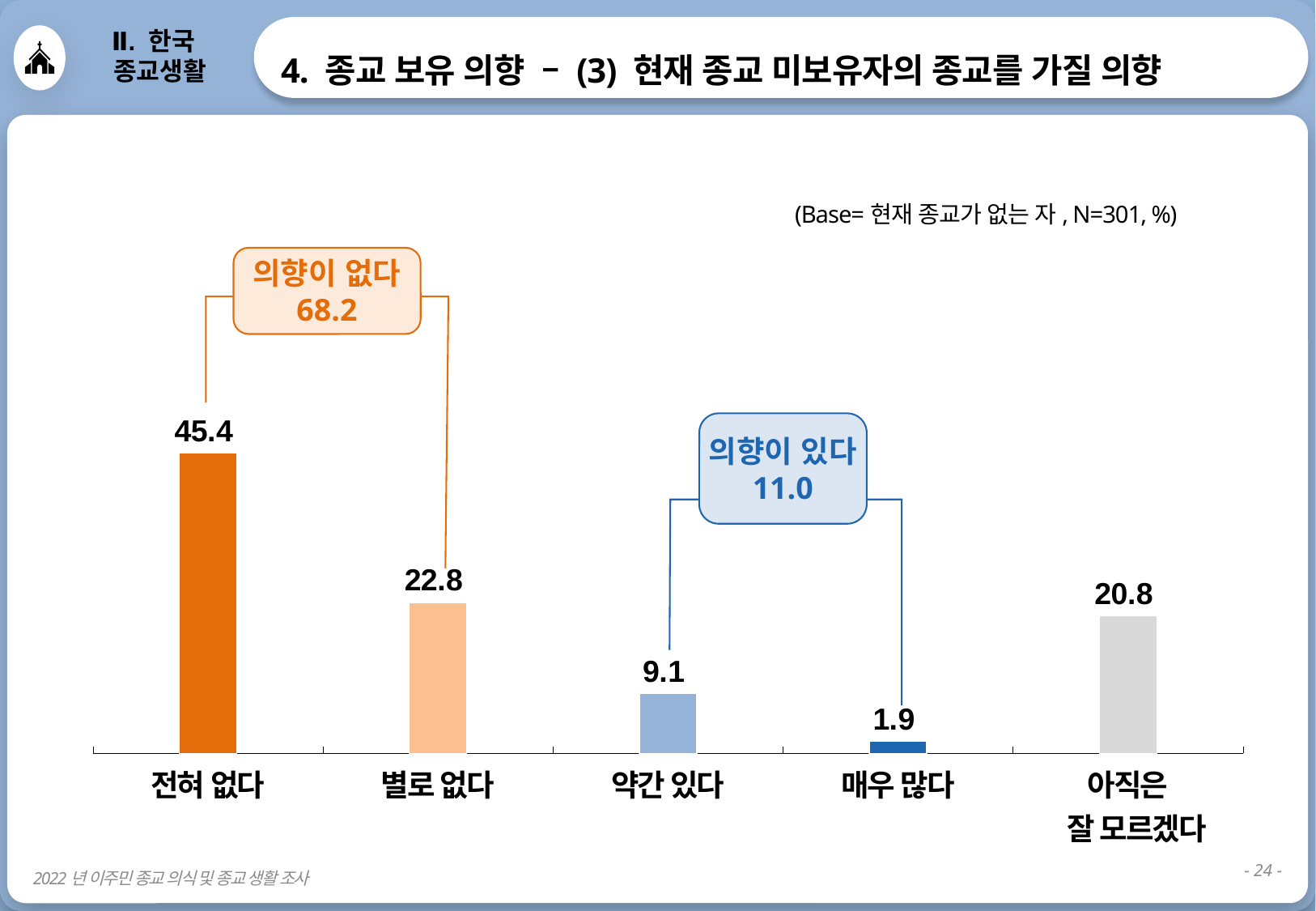
What is the difference between the values for 전혀 없다 and 별로 없다? 22.6 What kind of chart is shown on the slide? bar chart What combined value is shown in the callout labelled 의향이 없다? 68.2 What is the value for 매우 많다? 1.9 Which category has the lowest value? 매우 많다 How many categories are shown on the x axis? 5 Which category has the highest value? 전혀 없다 What is the value for 별로 없다? 22.8 What is the value for 약간 있다? 9.1 Which is larger, the value for 별로 없다 or the value for 아직은 잘 모르겠다? 별로 없다 What is the value for 아직은 잘 모르겠다? 20.8 What is the value for 전혀 없다? 45.4